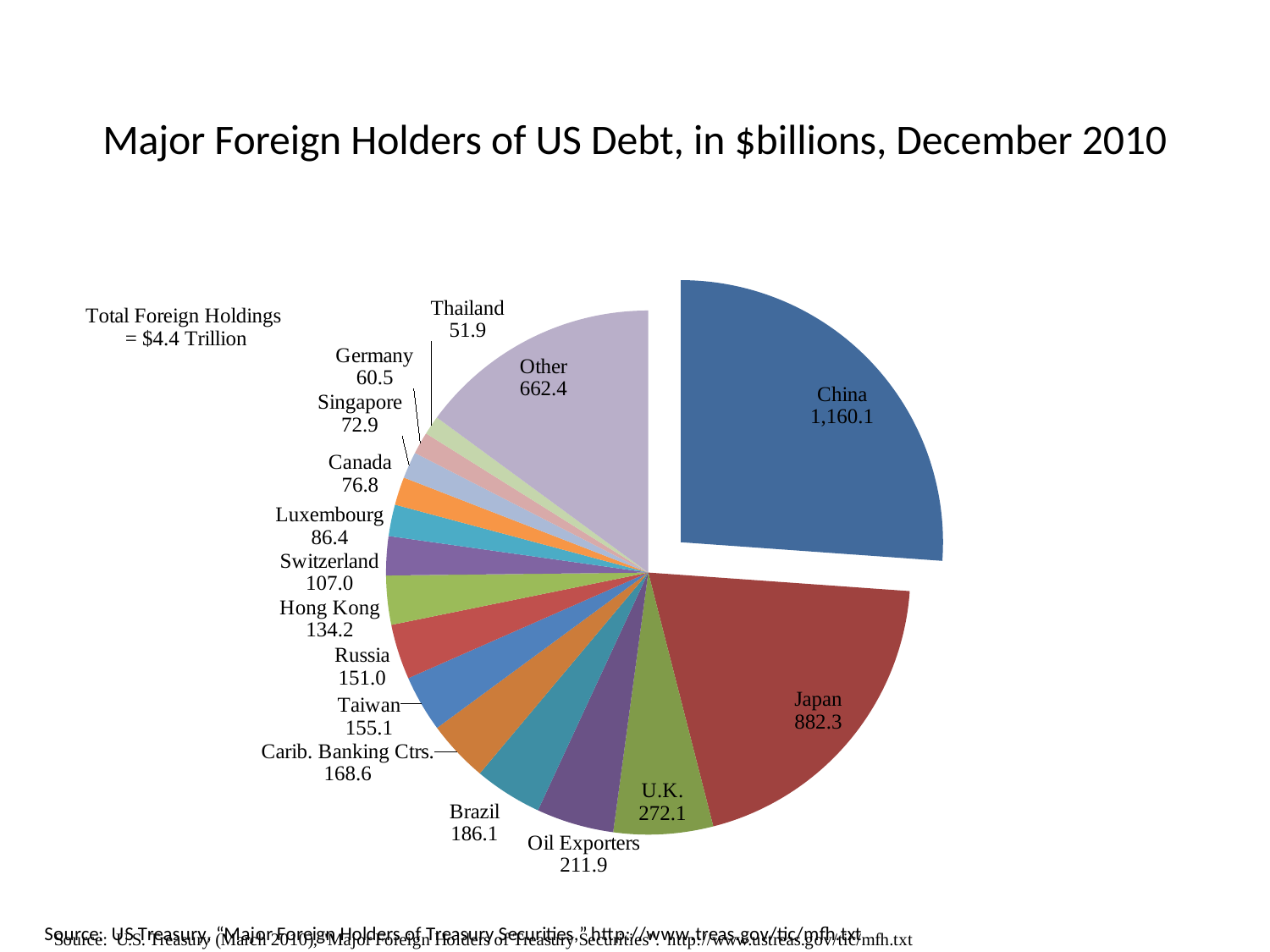
What is the value for Oil Exporters? 211.9 Which named holder has the smallest slice of the pie? Thailand What is the value for Japan? 882.3 What is the value for China? 1,160.1 How many slices does the pie chart have? 16 Which holder has the largest slice of the pie? China What is the difference between the values for China and Japan? 277.8 What is the difference between the values for Japan and the U.K.? 610.2 Which is larger, the value for Brazil or the value for Carib. Banking Ctrs.? Brazil What kind of chart is shown on the slide? Pie chart What is the value for Carib. Banking Ctrs.? 168.6 What is the title of the chart? Major Foreign Holders of US Debt, in $billions, December 2010